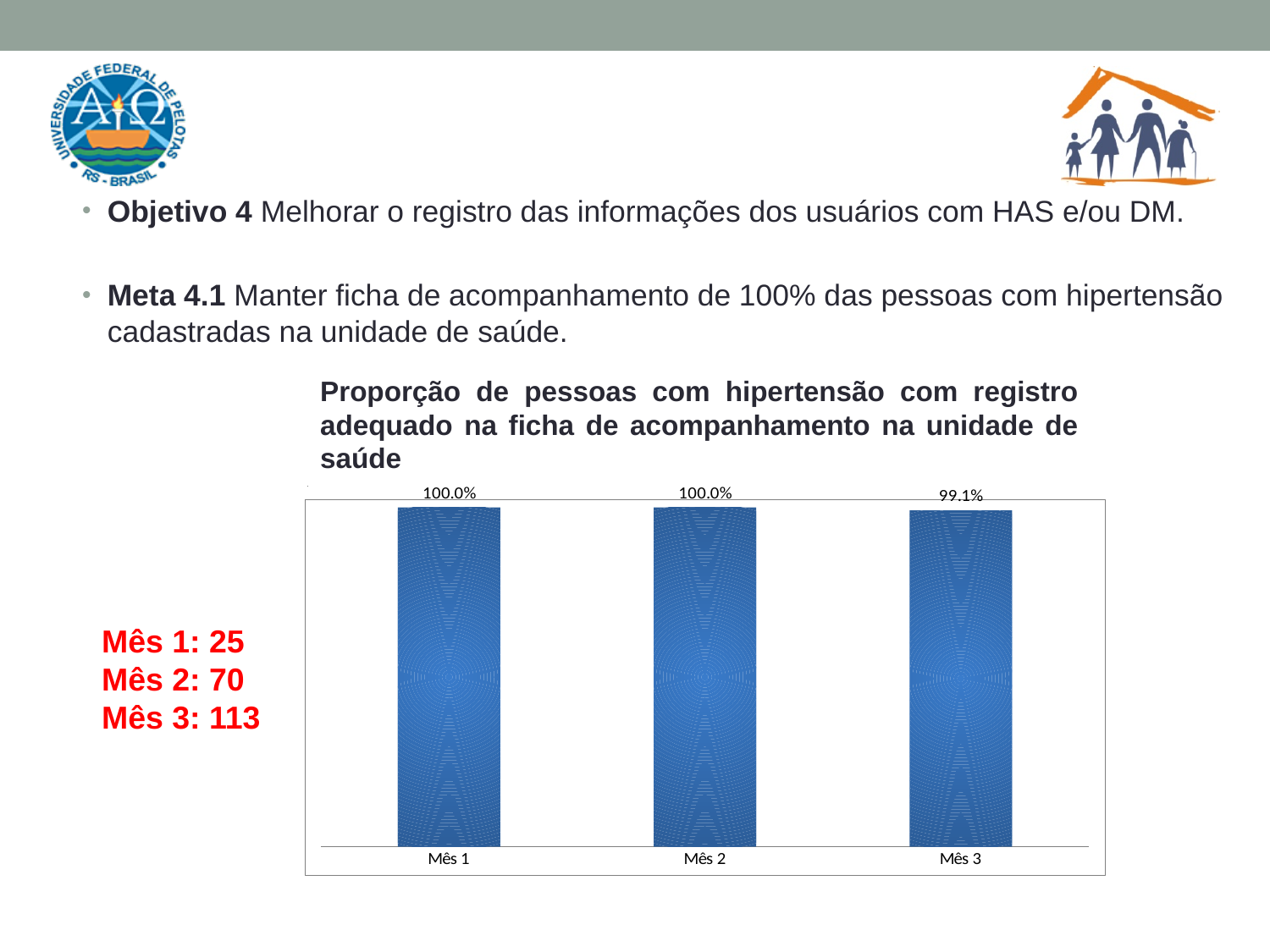
What is the value for Mês 3 in the chart? 99.1% What is the value for Mês 1 in the chart? 100.0% What kind of chart is shown on the slide? Bar chart Which month has the lowest value in the chart? Mês 3 Do the values rise or fall from Mês 2 to Mês 3? Fall Which is larger, the value for Mês 2 or the value for Mês 3? Mês 2 What is the value for Mês 2 in the chart? 100.0% What colour are the bars in the chart? Blue What is the difference between the values for Mês 1 and Mês 3? 0.9% What is the title of the chart? Proporção de pessoas com hipertensão com registro adequado na ficha de acompanhamento na unidade de saúde How many months (categories) are shown in the chart? 3 Do Mês 1 and Mês 2 have the same value? Yes